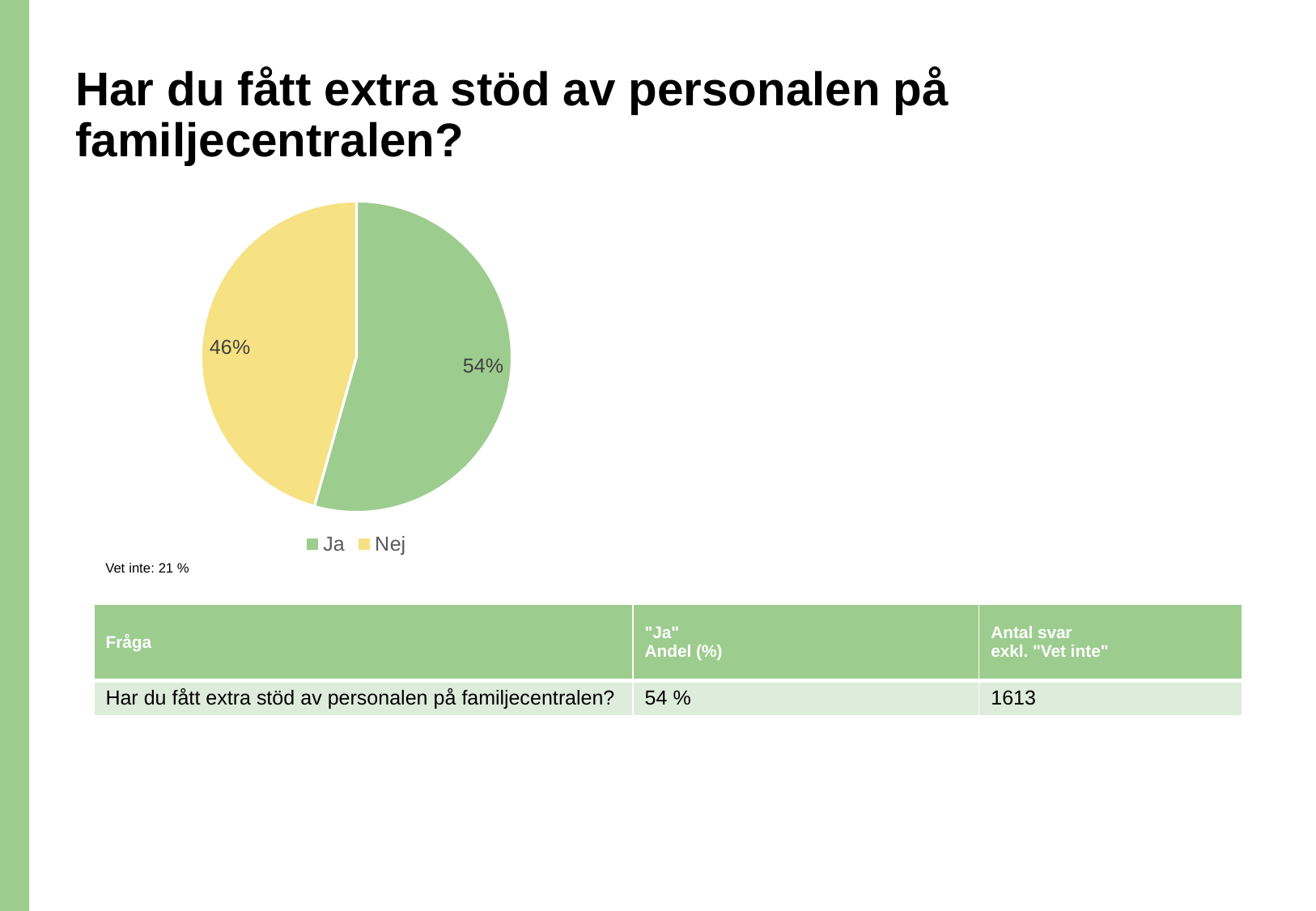
How many entries does the legend list? 2 What share of the pie does "Ja" represent? 54% What kind of chart is shown on the slide? pie chart What colour is the "Ja" slice in the pie chart? green Is the share for "Nej" greater or less than 50%? less What colour is the "Nej" slice in the pie chart? yellow What share of the pie does "Nej" represent? 46% Which is larger, the "Ja" slice or the "Nej" slice? Ja Which slice of the pie is the smallest? Nej How many slices does the pie chart have? 2 What is the difference in percentage points between the "Ja" and "Nej" slices? 8 Which slice of the pie is the largest? Ja